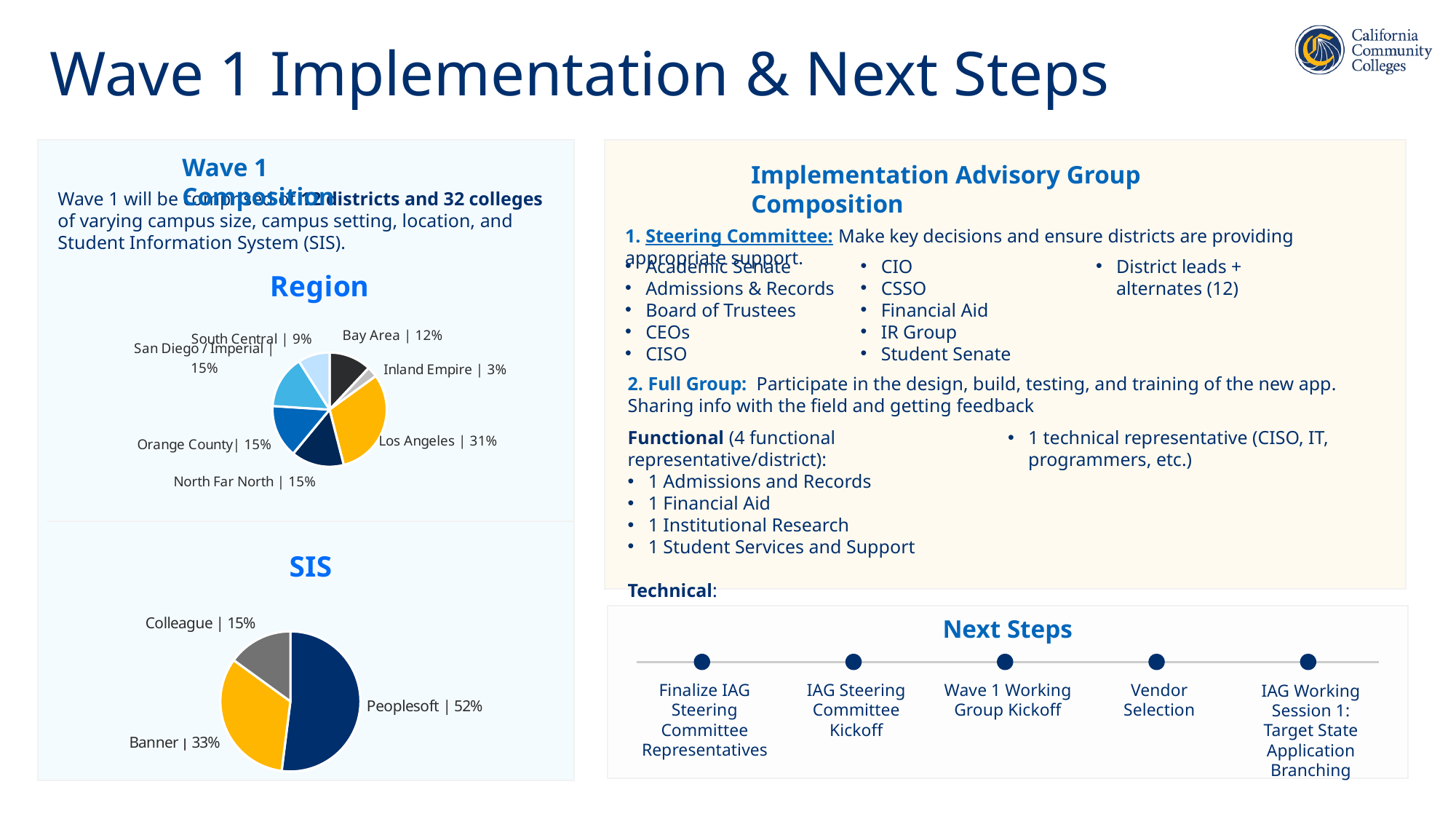
In the SIS chart, which system has the smallest share? Colleague In the Region chart, how many regions are shown? 7 In the Region chart, what share does Inland Empire have? 3% In the Region chart, which is larger, Bay Area or South Central? Bay Area In the SIS chart, what share does Peoplesoft have? 52% In the Region chart, which region has the largest share? Los Angeles In the Region chart, what is the difference between the Los Angeles share and the Bay Area share? 19% In the Region chart, what share does Los Angeles have? 31% What type of chart is the SIS chart? Pie chart In the Region chart, which region has the smallest share? Inland Empire In the SIS chart, what share does Banner have? 33% In the SIS chart, how many systems are shown? 3